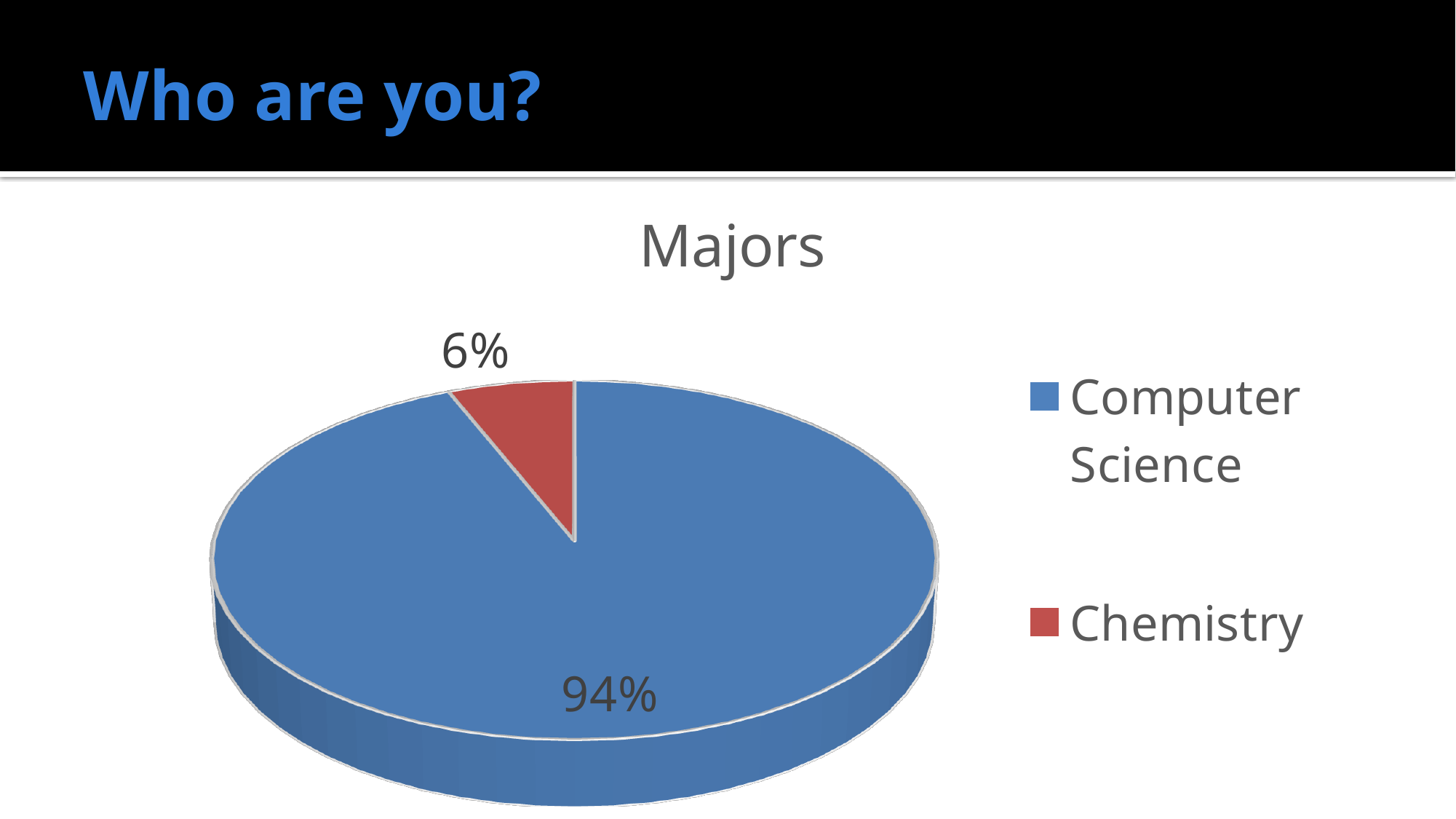
Which major has the smallest slice of the pie? Chemistry How many categories does the pie chart show? 2 What colour is the Chemistry slice? Red Which major has the largest slice of the pie? Computer Science What kind of chart is shown on the slide? Pie chart What share of the pie does Computer Science have? 94% What is the difference in percentage points between the Computer Science and Chemistry slices? 88 What share of the pie does Chemistry have? 6% What is the title of the chart? Majors Which is larger, the Computer Science slice or the Chemistry slice? Computer Science How many entries does the legend list? 2